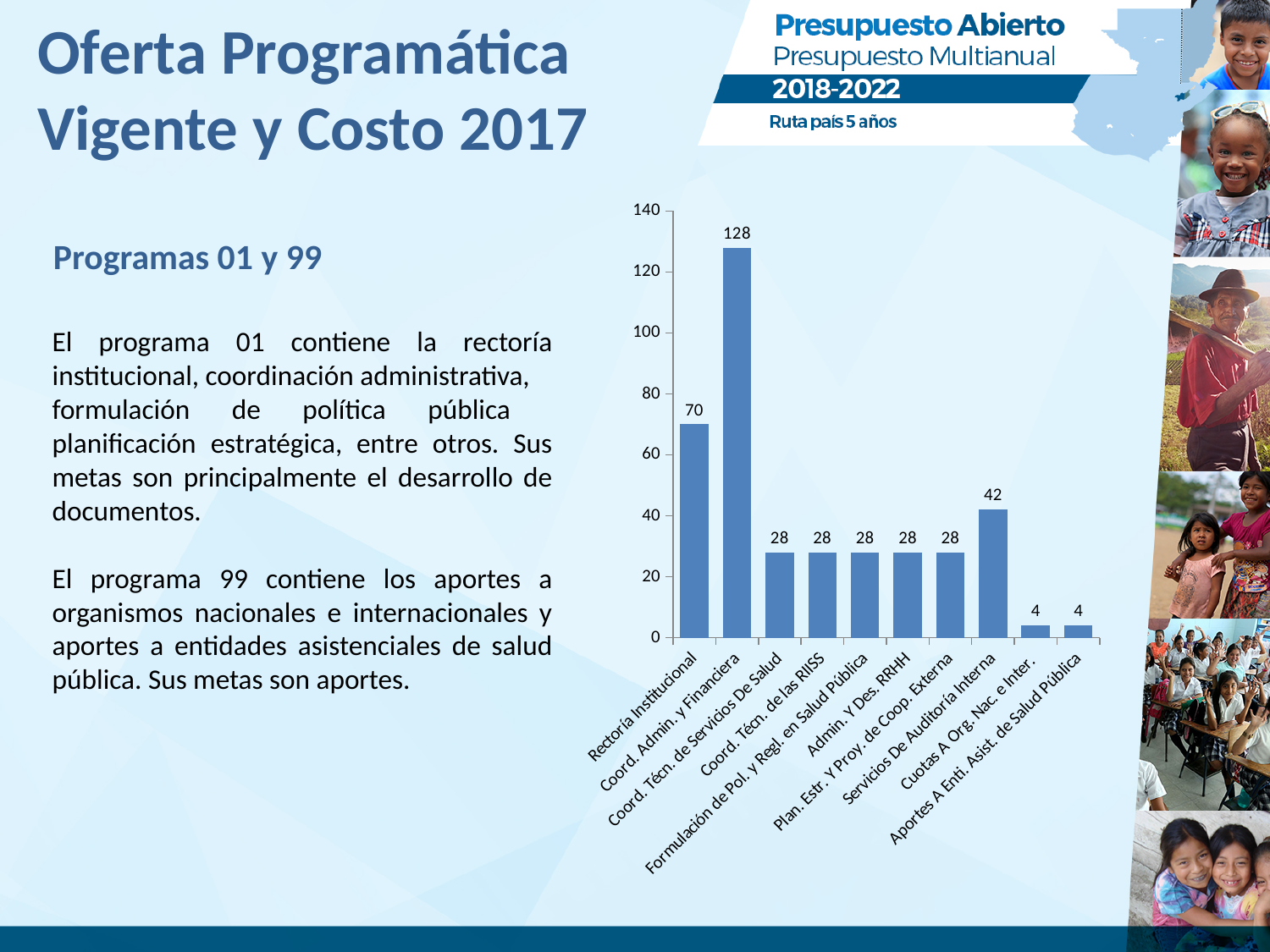
What is the value for Servicios De Auditoría Interna? 42 What is the value for Rectoría Institucional? 70 What is the value for Coord. Admin. y Financiera? 128 How many categories are shown in the chart? 10 What is the lowest value shown in the chart? 4 What is the value for Cuotas A Org. Nac e Inter.? 4 What is the difference between the values for Servicios De Auditoría Interna and Admin. Y Des. RRHH? 14 How many categories have a value of 28? 5 Which is larger, the value for Rectoría Institucional or the value for Servicios De Auditoría Interna? Rectoría Institucional Which category has the highest value? Coord. Admin. y Financiera What is the difference between the values for Coord. Admin. y Financiera and Rectoría Institucional? 58 What kind of chart is shown on the slide? Bar chart